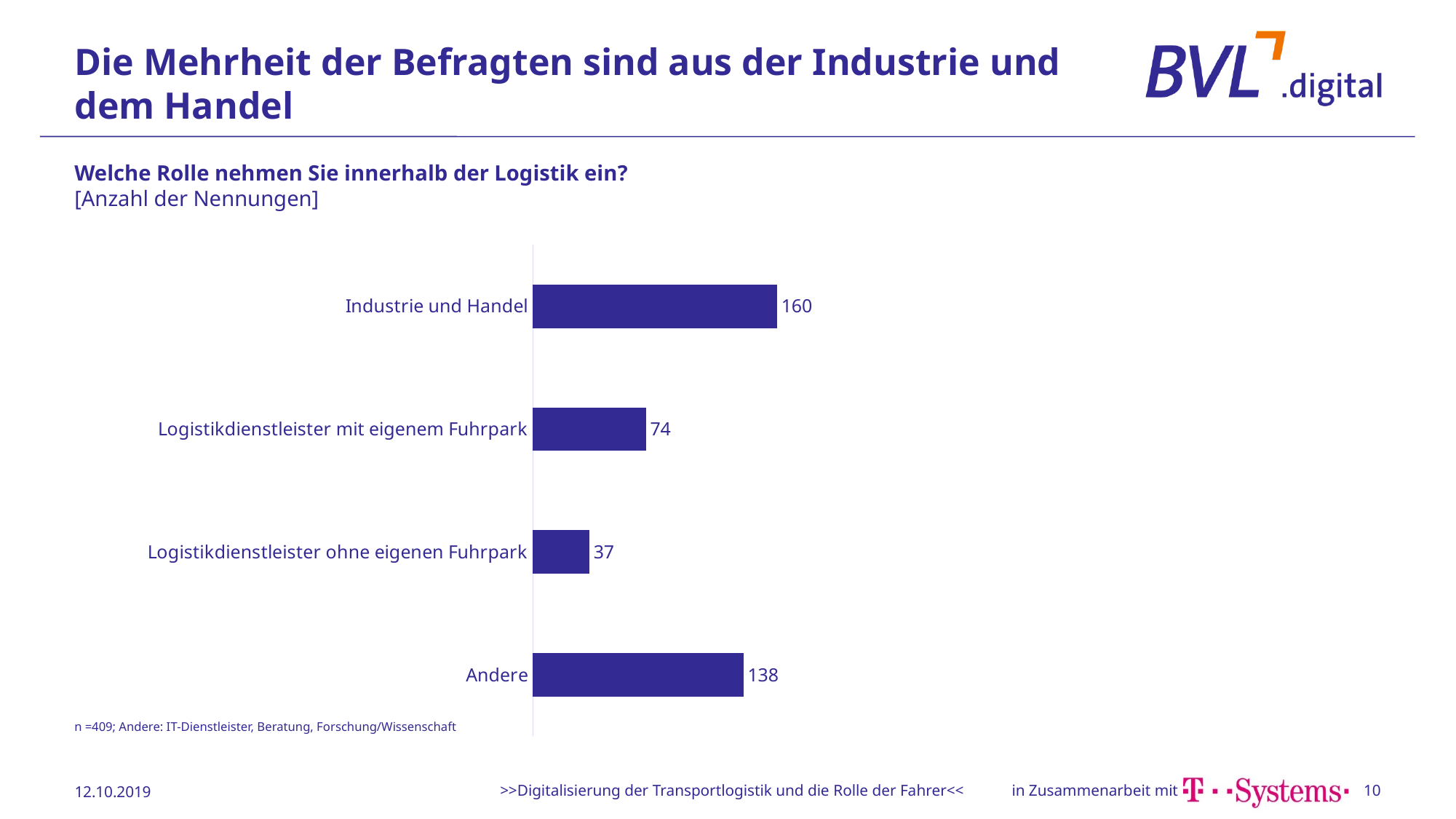
What is the difference between the values for Logistikdienstleister mit eigenem Fuhrpark and Logistikdienstleister ohne eigenen Fuhrpark? 37 What kind of chart is shown on the slide? Bar chart What is the value for Andere? 138 Which is larger, the value for Andere or the value for Logistikdienstleister mit eigenem Fuhrpark? Andere Which category has the highest value? Industrie und Handel What is the difference between the values for Industrie und Handel and Andere? 22 What is the value for Logistikdienstleister mit eigenem Fuhrpark? 74 Which category has the lowest value? Logistikdienstleister ohne eigenen Fuhrpark What question does the chart answer, according to the text above it? Welche Rolle nehmen Sie innerhalb der Logistik ein? What is the value for Industrie und Handel? 160 What is the value for Logistikdienstleister ohne eigenen Fuhrpark? 37 How many categories are shown in the chart? 4